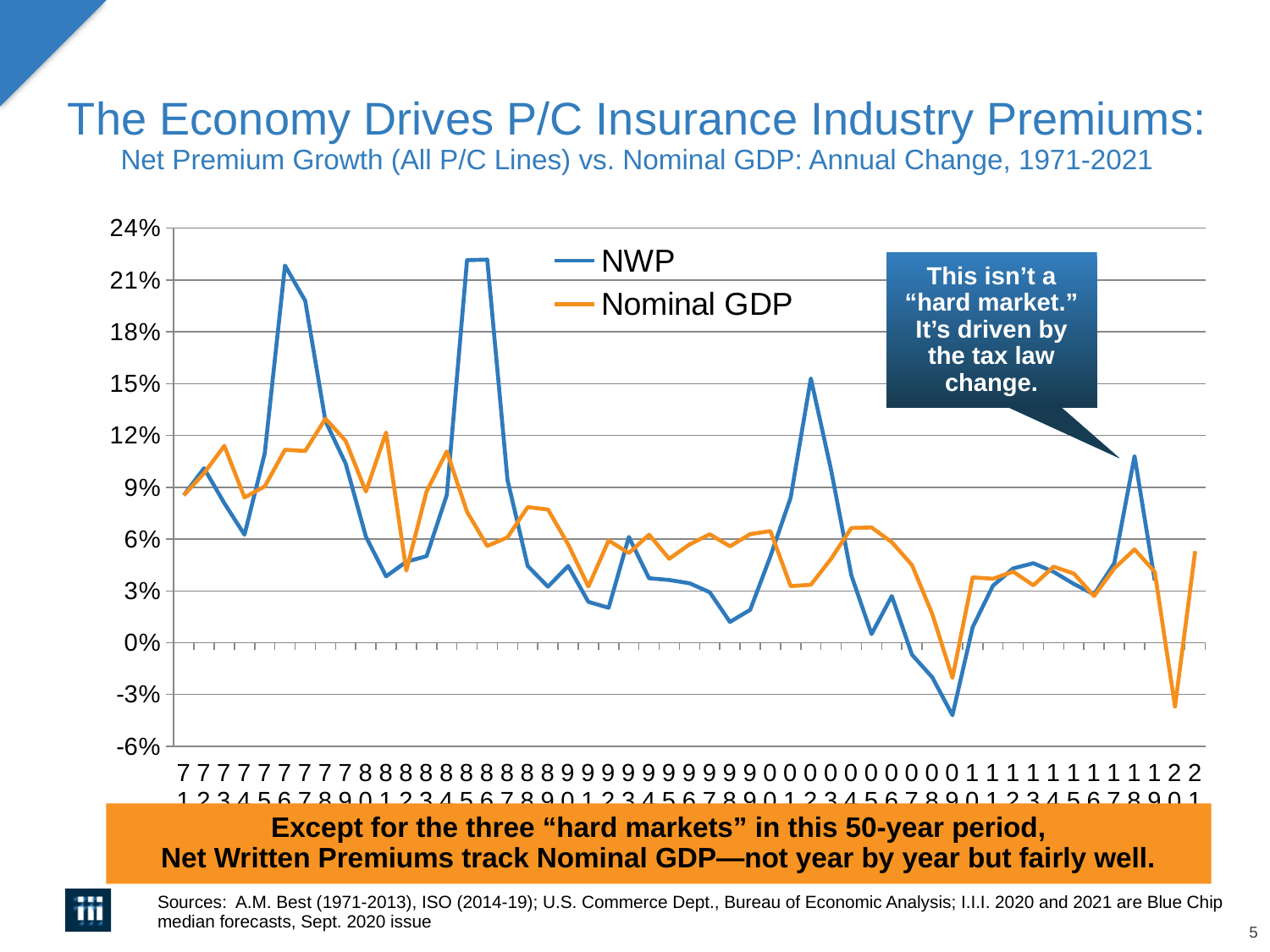
What kind of chart is shown on the slide? Line chart Is the lowest NWP value on the chart greater or less than -3%? less After its peak in the mid-1980s, does NWP rise or fall over the following years? fall Is the highest NWP value on the chart greater or less than 21%? greater What are the two series named in the legend? NWP and Nominal GDP Is the NWP peak in 2018 greater or less than 9%? greater How many years does the chart cover, from 1971 to 2021? 51 Which series is drawn in orange? Nominal GDP What is the highest value shown on the vertical axis? 24% Which series reaches the highest value anywhere on the chart? NWP How many series does the legend list? 2